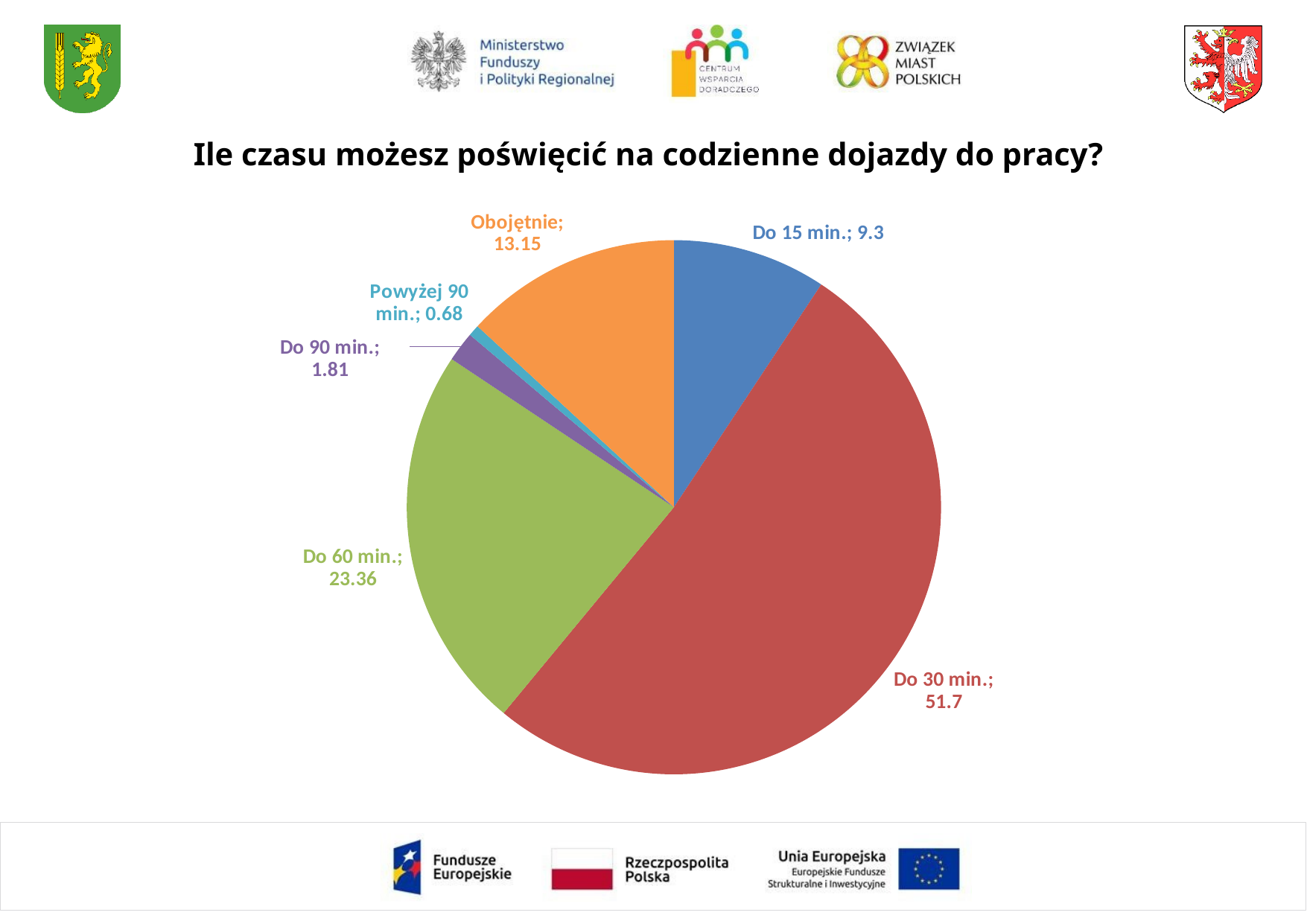
What is the value for "Powyżej 90 min."? 0.68 What is the value for "Obojętnie"? 13.15 What type of chart is shown on the slide? pie chart What is the value for "Do 15 min."? 9.3 What is the value for "Do 30 min."? 51.7 Which category has the largest slice? Do 30 min. What is the value for "Do 60 min."? 23.36 How many slices does the pie chart have? 6 Which is larger, the value for "Obojętnie" or the value for "Do 15 min."? Obojętnie What is the title of the chart? Ile czasu możesz poświęcić na codzienne dojazdy do pracy? Which category has the smallest slice? Powyżej 90 min. What is the difference between the values for "Do 30 min." and "Do 60 min."? 28.34